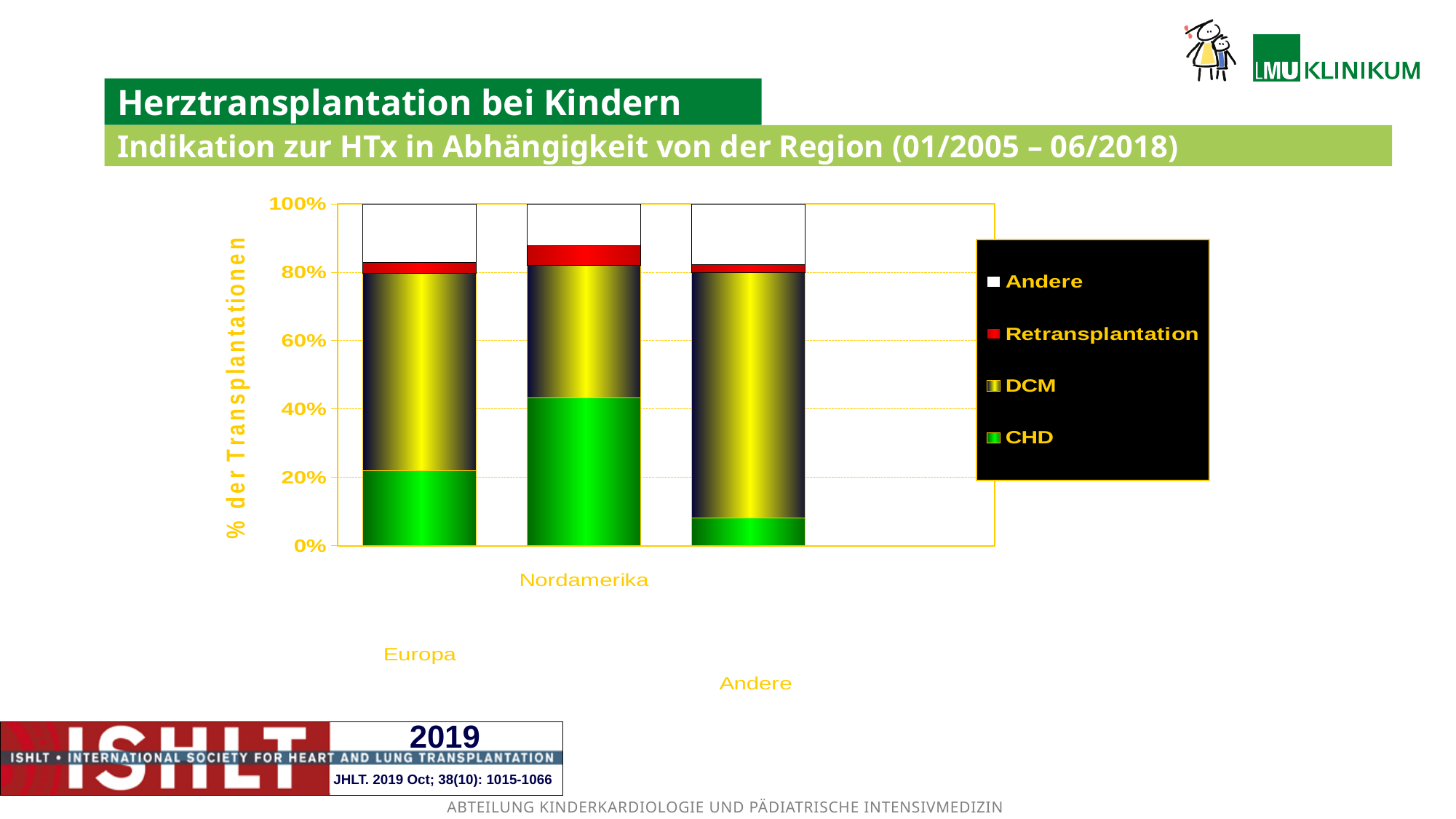
Is the CHD value for Nordamerika greater or less than 40%? greater Which region has the lowest CHD share? Andere Is the CHD value for Europa greater or less than 40%? less How many series does the chart legend list? 4 How many regions (categories) are shown on the x axis of the chart? 3 Which region has the larger CHD share, Europa or Andere? Europa What kind of chart is shown on the slide? Stacked bar chart What is the label of the y axis of the chart? % der Transplantationen Which series is shown in red in the chart legend? Retransplantation Which region has the highest CHD share? Nordamerika What is the total of the stacked bar for Europa? 100% Is the CHD value for Andere greater or less than 20%? less